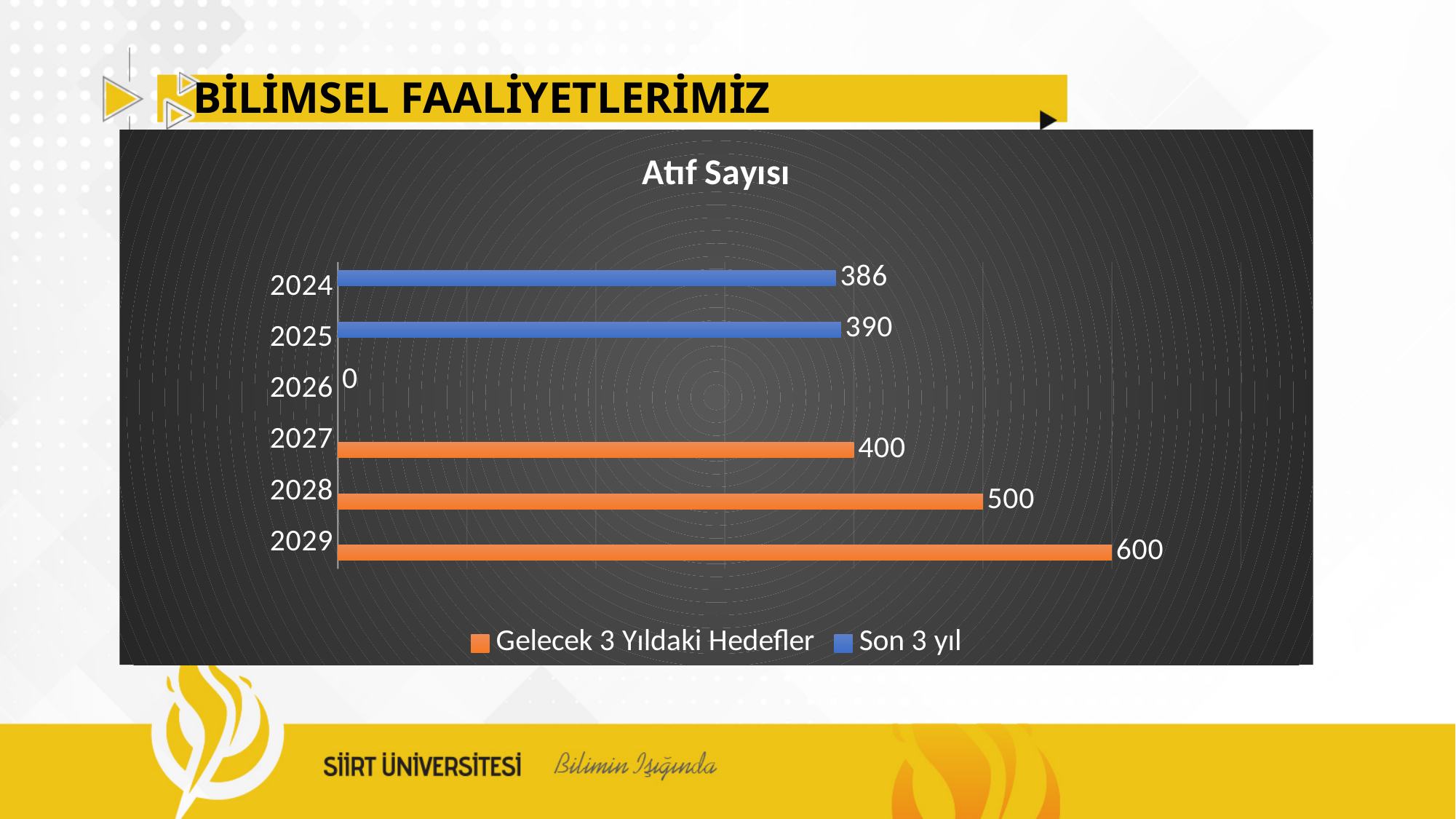
What type of chart is shown on the slide? bar chart Which year has the lowest value? 2026 What is the value for 2028? 500 Which year has the highest value? 2029 What is the difference between the values for 2029 and 2027? 200 Which is larger, the value for 2025 or the value for 2024? 2025 What is the value for 2024? 386 What is the title of the chart? Atıf Sayısı How many years are shown on the chart? 6 How many series does the legend list? 2 What is the value for 2025? 390 What is the value for 2026? 0